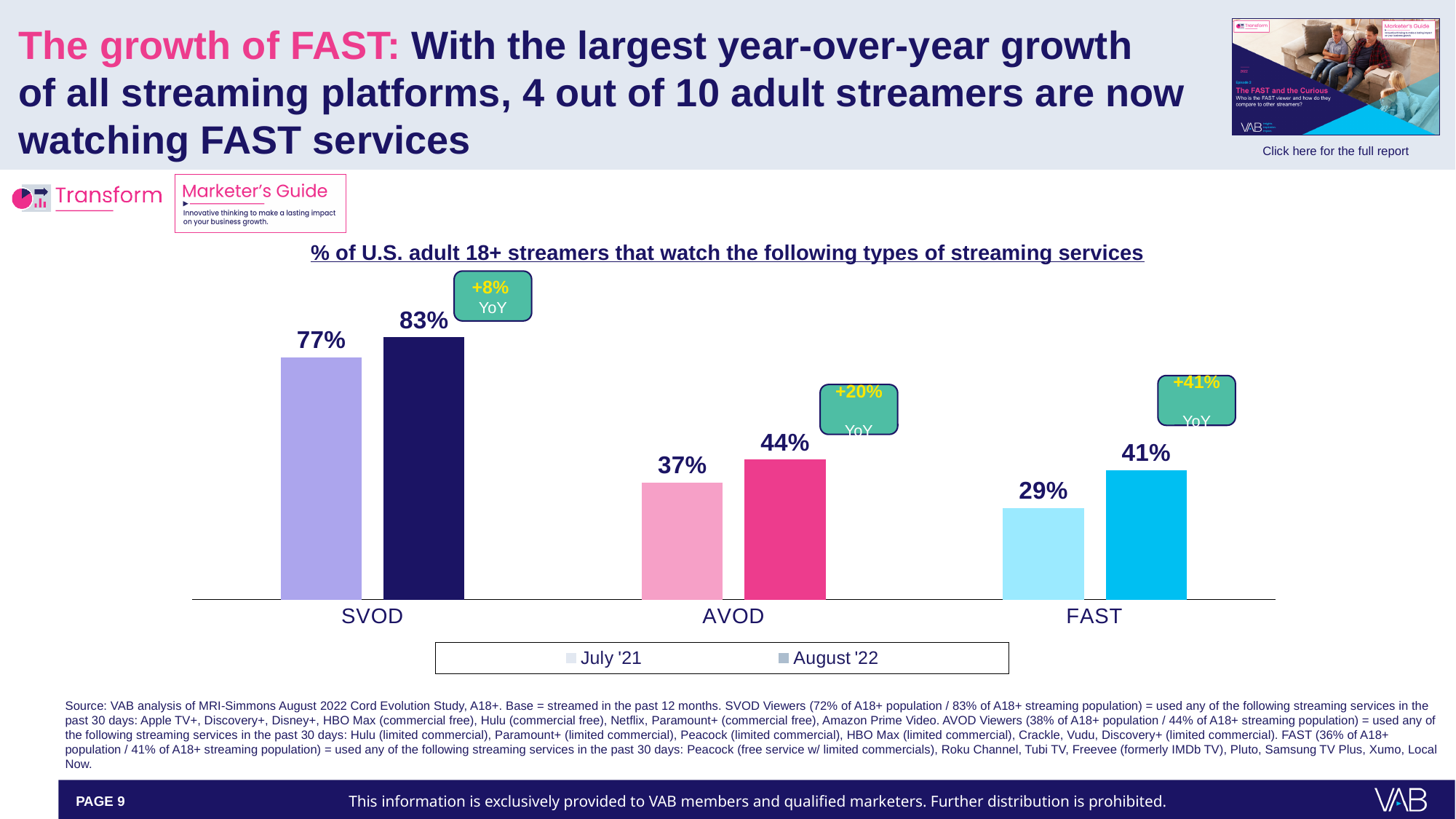
What is the August '22 value for AVOD? 44% What is the difference between the August '22 and July '21 values for FAST? 12 percentage points What percentage of U.S. adult 18+ streamers watched SVOD services in August '22? 83% What is the difference between the SVOD and AVOD values in July '21? 40 percentage points How many series does the legend list? 2 Which type of streaming service has the lowest July '21 value? FAST What percentage of U.S. adult 18+ streamers watched FAST services in July '21? 29% Which type of streaming service has the highest August '22 value? SVOD How many types of streaming services are shown on the x axis? 3 What kind of chart is shown on the slide? Bar chart Which is larger: the August '22 value for AVOD or the August '22 value for FAST? AVOD What year-over-year growth is labelled for FAST? +41%